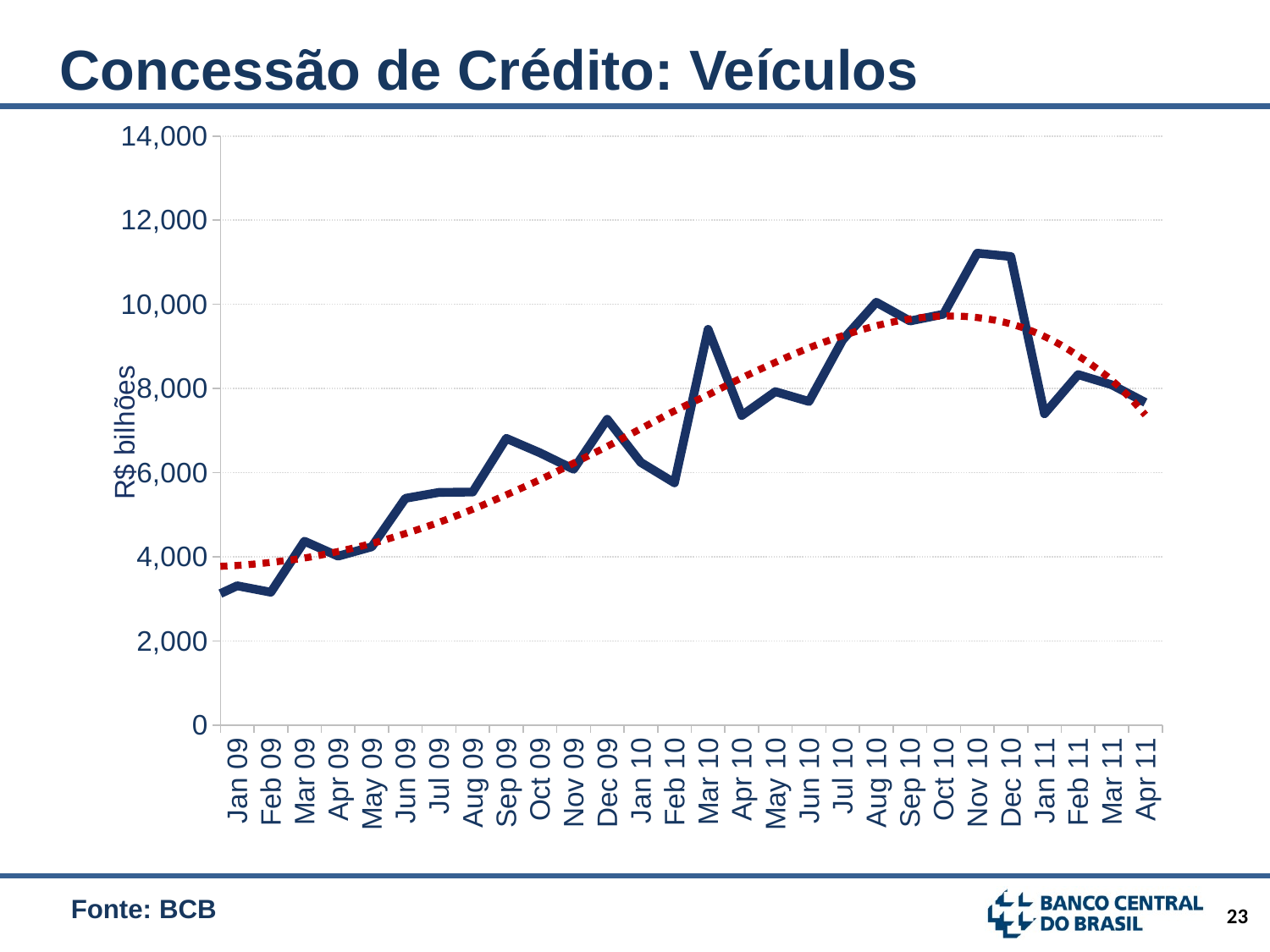
Which month has the larger value, Dec 10 or Jan 11? Dec 10 How many monthly data points are plotted along the x axis? 28 Is the value for Mar 10 greater or less than 8,000? greater Which month has the larger value, Mar 10 or Apr 10? Mar 10 Is the value for Sep 09 greater or less than 6,000? greater Is the value for Nov 10 greater or less than 10,000? greater In which month does the solid line reach its highest value? Nov 10 What kind of chart is shown on the slide? line chart What is the label on the vertical axis? R$ bilhões Does the solid line generally rise or fall from Jan 09 to Nov 10? rise